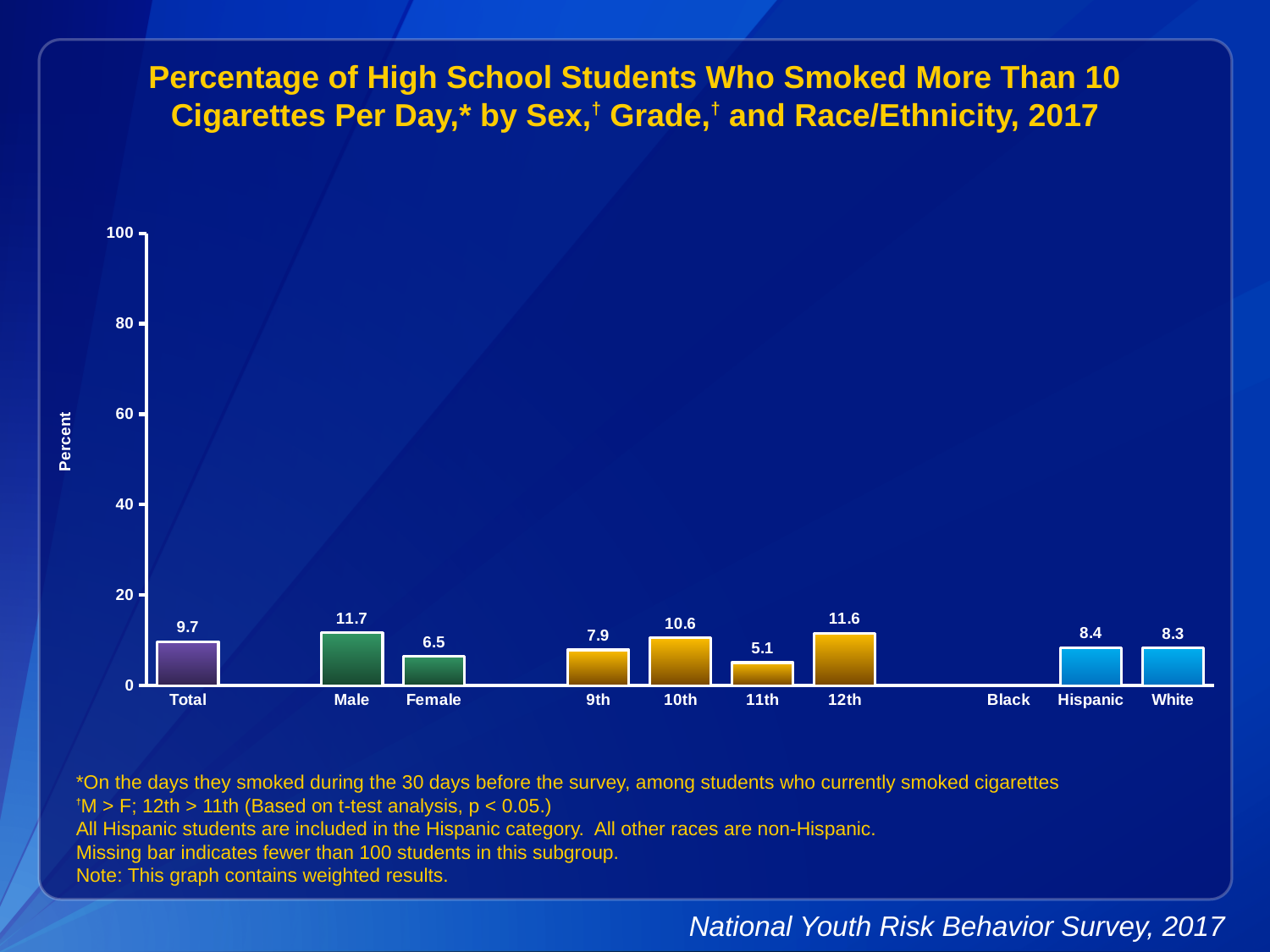
What is the value for 11th grade? 5.1 What is the difference between the Male and Female values? 5.2 Is the value for 12th grade greater or less than 20? less What percentage is shown for Male students? 11.7 How many bars are plotted on the chart? 9 Which category label on the x axis has no bar plotted? Black Among the grade categories (9th, 10th, 11th, 12th), which has the highest value? 12th What is the value for Total? 9.7 Which category has the lowest value on the chart? 11th What type of chart is shown on the slide? bar chart Which is larger, the value for 10th grade or the value for 9th grade? 10th What is the value for Hispanic students? 8.4